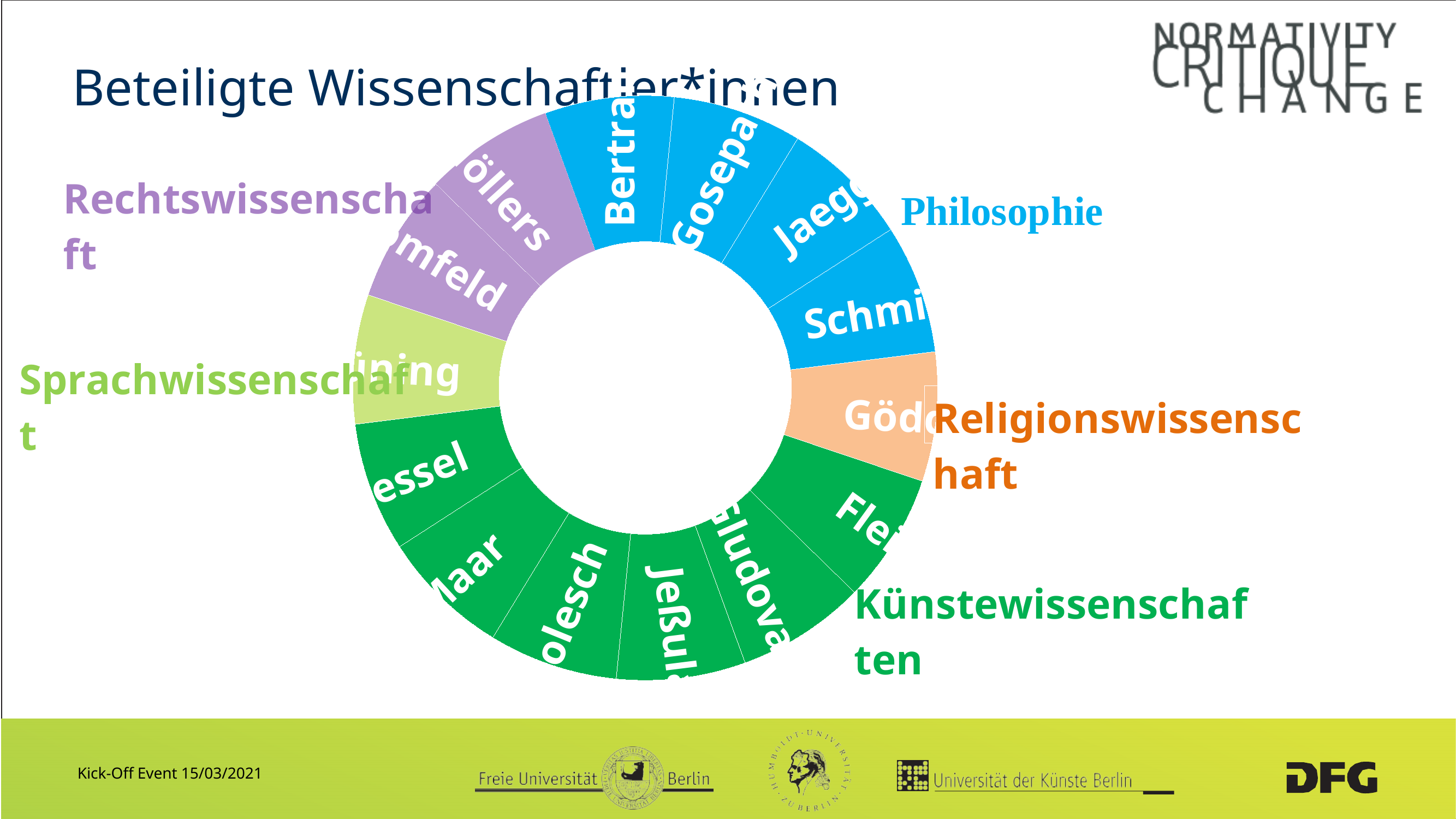
Which group has more segments, Künstewissenschaften or Philosophie? Künstewissenschaften How many discipline groups are labelled around the chart? 5 How many segments does the chart contain in total? 14 How many segments belong to the Philosophie group? 4 What is the title of the slide containing the chart? Beteiligte Wissenschaftler*innen What kind of chart is shown on the slide? Doughnut chart Which group has more segments, Philosophie or Rechtswissenschaft? Philosophie What colour are the Philosophie segments in the chart? Blue Which discipline group has the most segments in the chart? Künstewissenschaften Which discipline group does the segment labelled Maar belong to? Künstewissenschaften